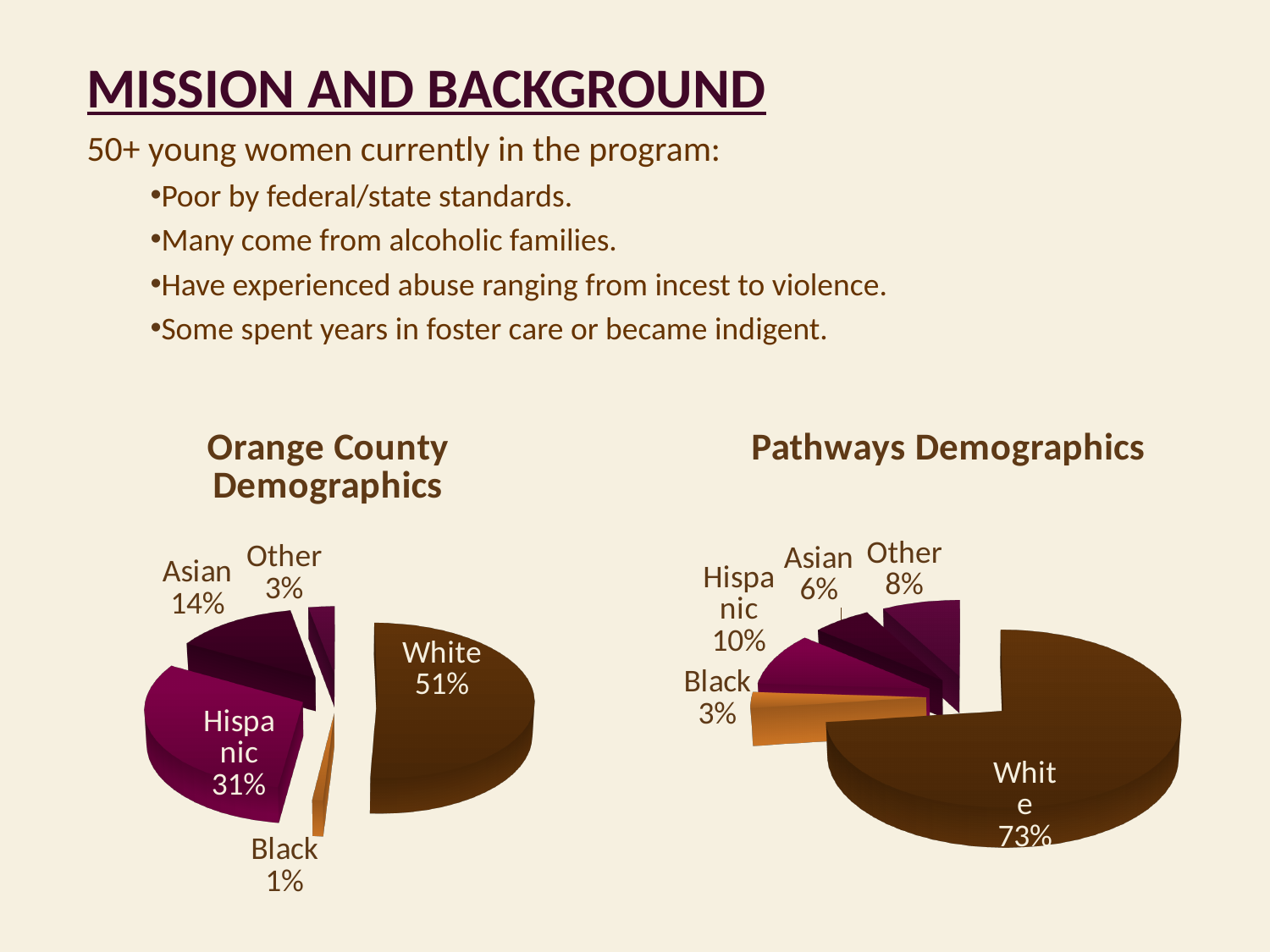
What is the difference between the White percentage in the Pathways Demographics chart and the White percentage in the Orange County Demographics chart? 22% In the Pathways Demographics chart, what percentage is shown for White? 73% How many categories are shown in the Pathways Demographics chart? 5 In the Orange County Demographics chart, which category has the smallest slice? Black In the Pathways Demographics chart, what percentage is shown for Black? 3% In the Orange County Demographics chart, what is the difference between the Hispanic and Asian percentages? 17% Which is larger: the Asian share in the Orange County Demographics chart or the Asian share in the Pathways Demographics chart? Orange County Demographics In the Pathways Demographics chart, which category has the smallest slice? Black In the Orange County Demographics chart, which category has the largest slice? White What is the title of the chart on the right side of the slide? Pathways Demographics What type of chart is the Orange County Demographics chart? Pie chart In the Orange County Demographics chart, what percentage is shown for Hispanic? 31%